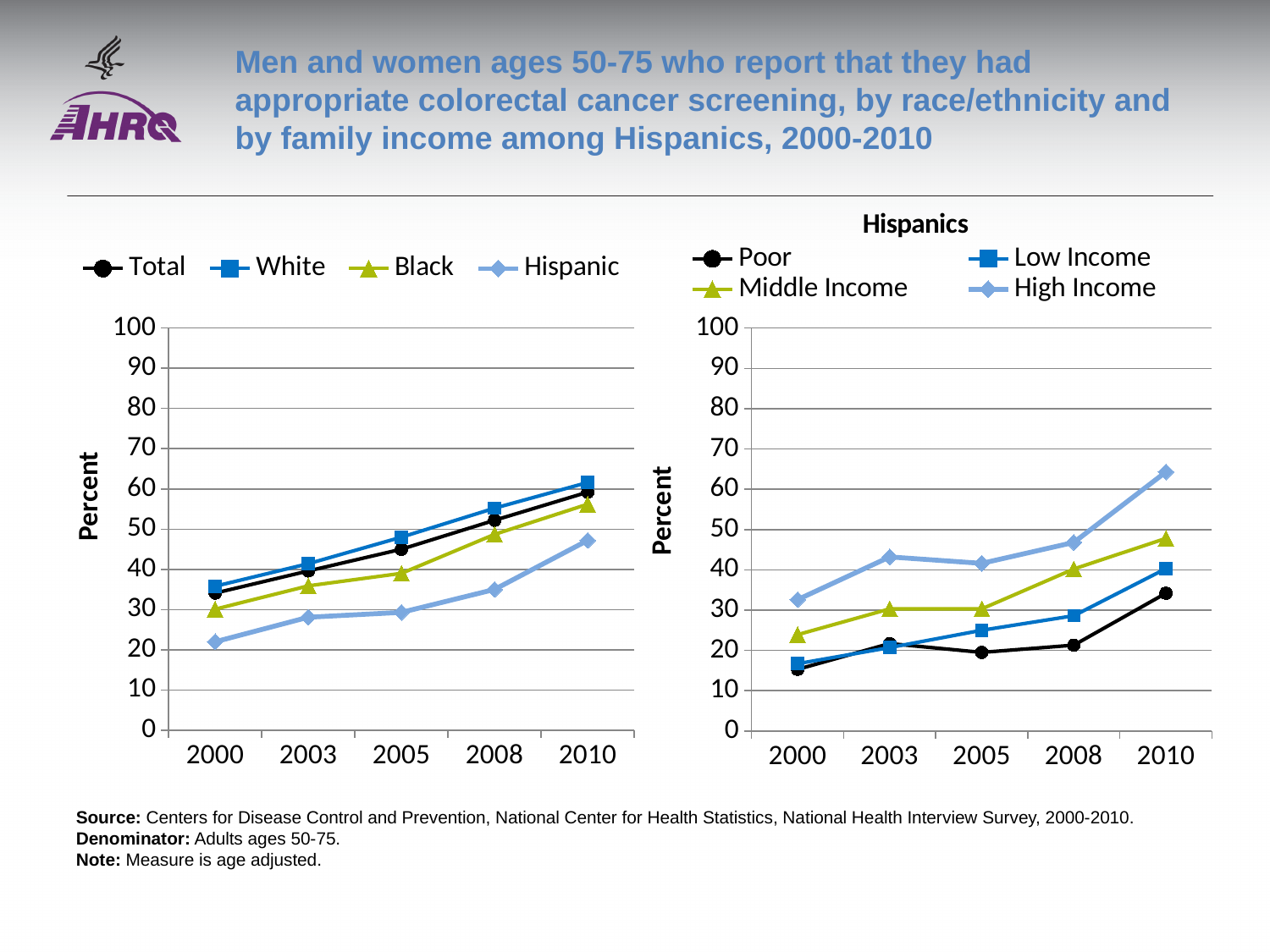
In the left chart, is the value for Hispanic in 2000 greater or less than 30? less What is the title of the right chart? Hispanics In the right chart titled Hispanics, which is larger in 2008, Middle Income or Low Income? Middle Income What kind of chart is the left chart (by race/ethnicity)? line chart In the left chart, which group has the lowest value in 2010? Hispanic How many years are shown on the x axis of the right chart titled Hispanics? 5 In the right chart titled Hispanics, which income group has the highest value in 2010? High Income How many series does the legend of the left chart list? 4 In the right chart titled Hispanics, which income group has the lowest value in 2010? Poor In the left chart, does the Total series rise or fall from 2000 to 2010? rise In the left chart, is the value for White in 2010 greater or less than 50? greater In the right chart titled Hispanics, is the value for High Income in 2010 greater or less than 60? greater